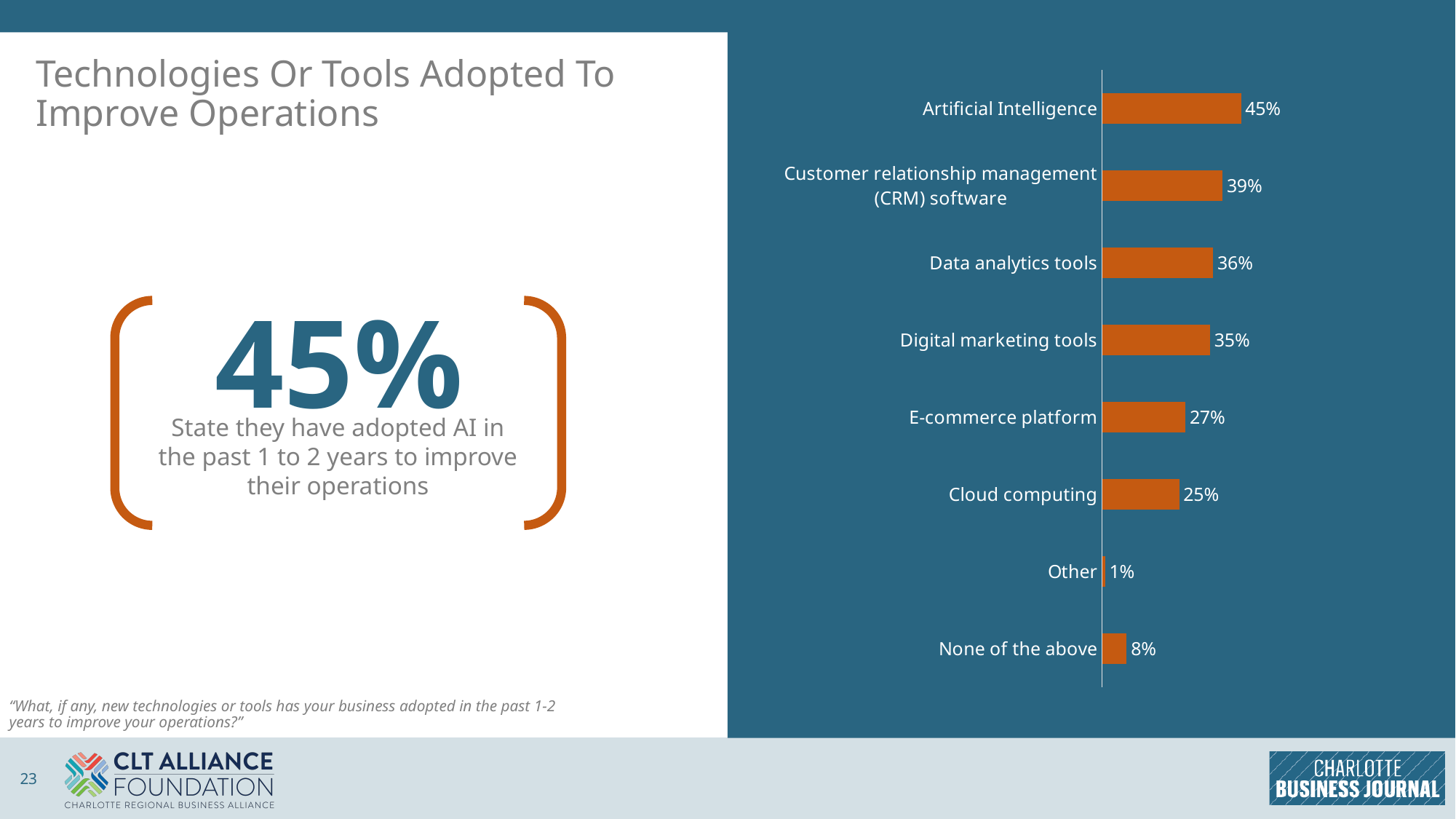
Which category has the lowest value? Other Which is larger, Digital marketing tools or E-commerce platform? Digital marketing tools What is the value for Cloud computing? 25% What is the title of the slide containing the chart? Technologies Or Tools Adopted To Improve Operations Which category has the highest value? Artificial Intelligence What is the value for None of the above? 8% How many categories are shown in the chart? 8 What kind of chart is shown on the slide? Bar chart What is the value for Customer relationship management (CRM) software? 39% What percentage of respondents adopted Artificial Intelligence? 45% What is the difference between E-commerce platform and Cloud computing? 2% What is the difference between Artificial Intelligence and Data analytics tools? 9%